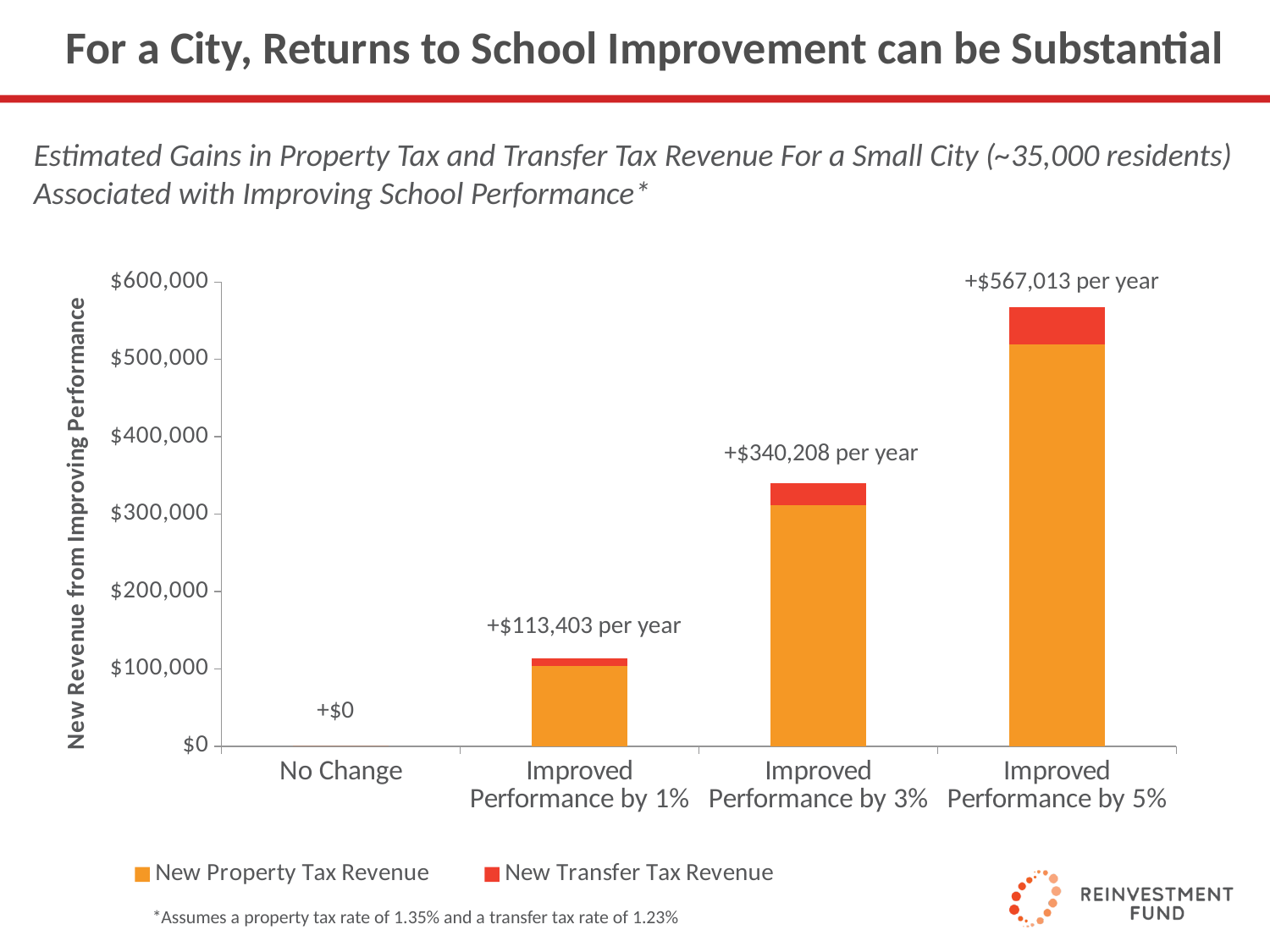
What kind of chart is shown on the slide? Stacked bar chart What is the total labeled value for the Improved Performance by 1% bar? +$113,403 per year What is the difference between the total for Improved Performance by 5% and the total for Improved Performance by 3%? $226,805 Which category has the lowest total new revenue? No Change Is the New Transfer Tax Revenue portion of the Improved Performance by 5% bar greater or less than $100,000? less Which category has the highest total new revenue? Improved Performance by 5% What is the total labeled value for the Improved Performance by 3% bar? +$340,208 per year How many categories are shown on the x axis? 4 Which is larger: the total for Improved Performance by 3% or the total for Improved Performance by 1%? Improved Performance by 3% Do the total values rise or fall moving from left to right along the x axis? Rise How many series does the legend list? 2 What is the total labeled value for the Improved Performance by 5% bar? +$567,013 per year